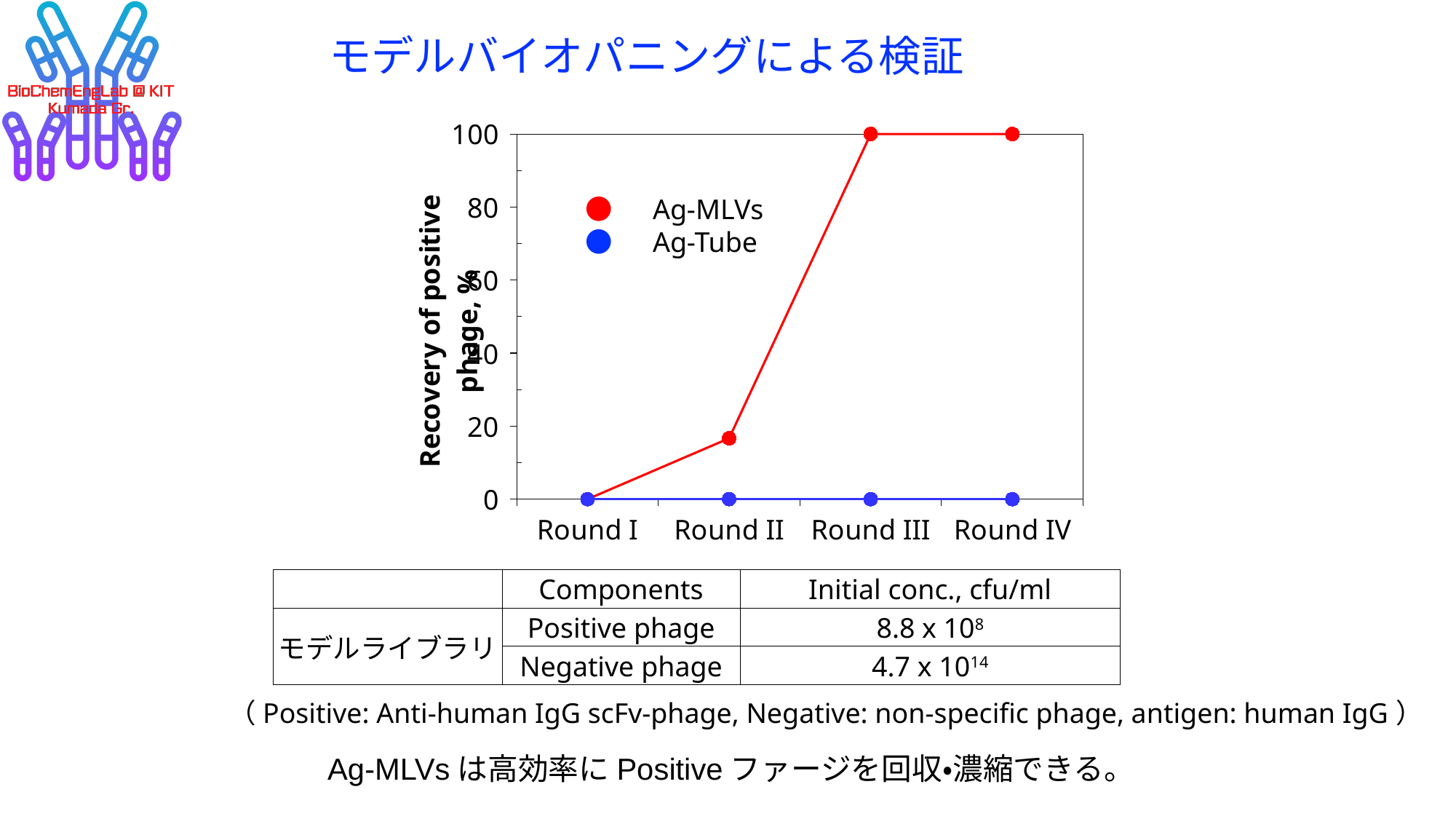
What is the difference between the Ag-MLVs and Ag-Tube values at Round IV? 100 Does the Ag-MLVs series rise or fall from Round I to Round III? rise At Round III, which series has the higher recovery, Ag-MLVs or Ag-Tube? Ag-MLVs What is the recovery of positive phage for Ag-MLVs at Round III? 100 How many series does the legend list? 2 What is the recovery of positive phage for Ag-MLVs at Round I? 0 At which round is the Ag-MLVs recovery lowest? Round I Which colour represents the Ag-Tube series in the legend? blue Is the value for Ag-MLVs at Round II greater or less than 20? less What is the recovery of positive phage for Ag-Tube at Round IV? 0 What kind of chart is shown on the slide? line chart How many rounds are shown on the x axis? 4